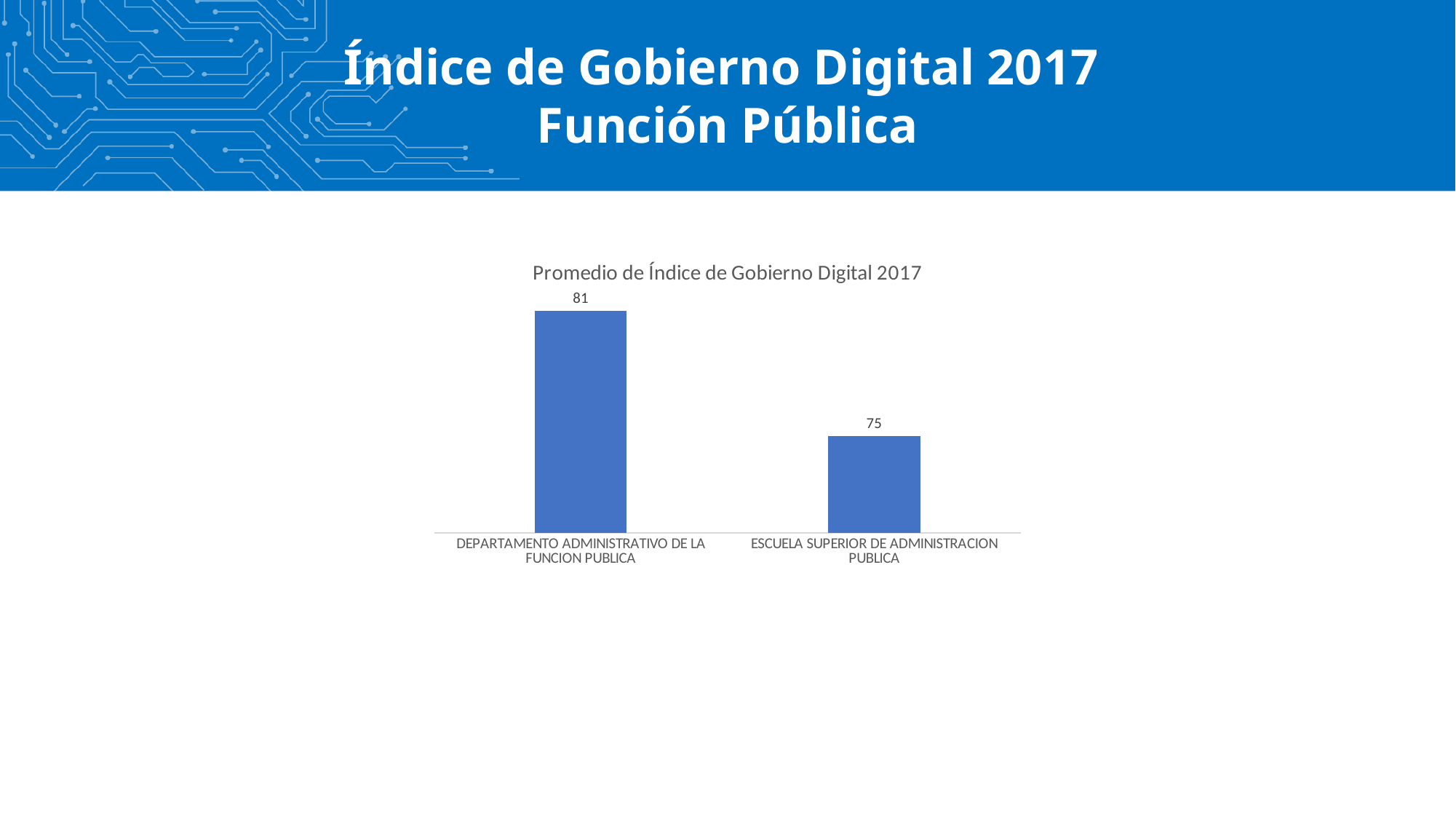
Do the values rise or fall from left to right across the categories? Fall What is the value for ESCUELA SUPERIOR DE ADMINISTRACION PUBLICA? 75 Which is larger, the value for DEPARTAMENTO ADMINISTRATIVO DE LA FUNCION PUBLICA or the value for ESCUELA SUPERIOR DE ADMINISTRACION PUBLICA? DEPARTAMENTO ADMINISTRATIVO DE LA FUNCION PUBLICA What kind of chart is shown on the slide? Bar chart Which category has the lowest value? ESCUELA SUPERIOR DE ADMINISTRACION PUBLICA What is the title of the chart? Promedio de Índice de Gobierno Digital 2017 How many categories are shown in the chart? 2 What is the difference between the values for DEPARTAMENTO ADMINISTRATIVO DE LA FUNCION PUBLICA and ESCUELA SUPERIOR DE ADMINISTRACION PUBLICA? 6 What colour are the bars in the chart? Blue Which category has the highest value? DEPARTAMENTO ADMINISTRATIVO DE LA FUNCION PUBLICA What is the value for DEPARTAMENTO ADMINISTRATIVO DE LA FUNCION PUBLICA? 81